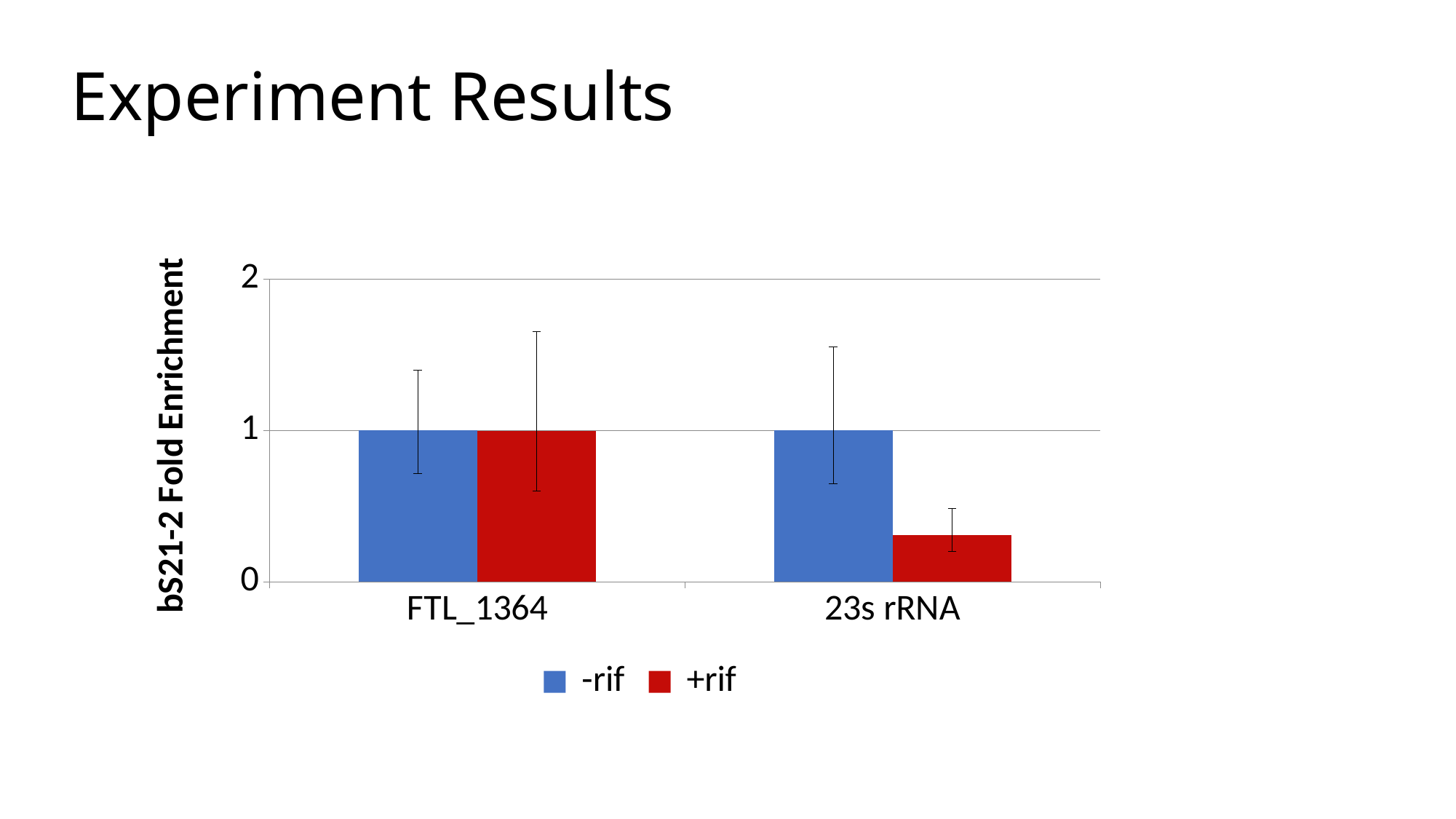
Which bar in the chart has the lowest value? +rif for 23s rRNA Is the +rif value for 23s rRNA greater or less than 1? less What kind of chart is shown on the slide? bar chart Which series is shown in red in the chart? +rif For 23s rRNA, which series has the larger value, -rif or +rif? -rif How many series does the chart's legend list? 2 What is the -rif value for FTL_1364? 1 What is the label on the chart's y axis? bS21-2 Fold Enrichment What is the -rif value for 23s rRNA? 1 How many categories are shown on the x axis of the chart? 2